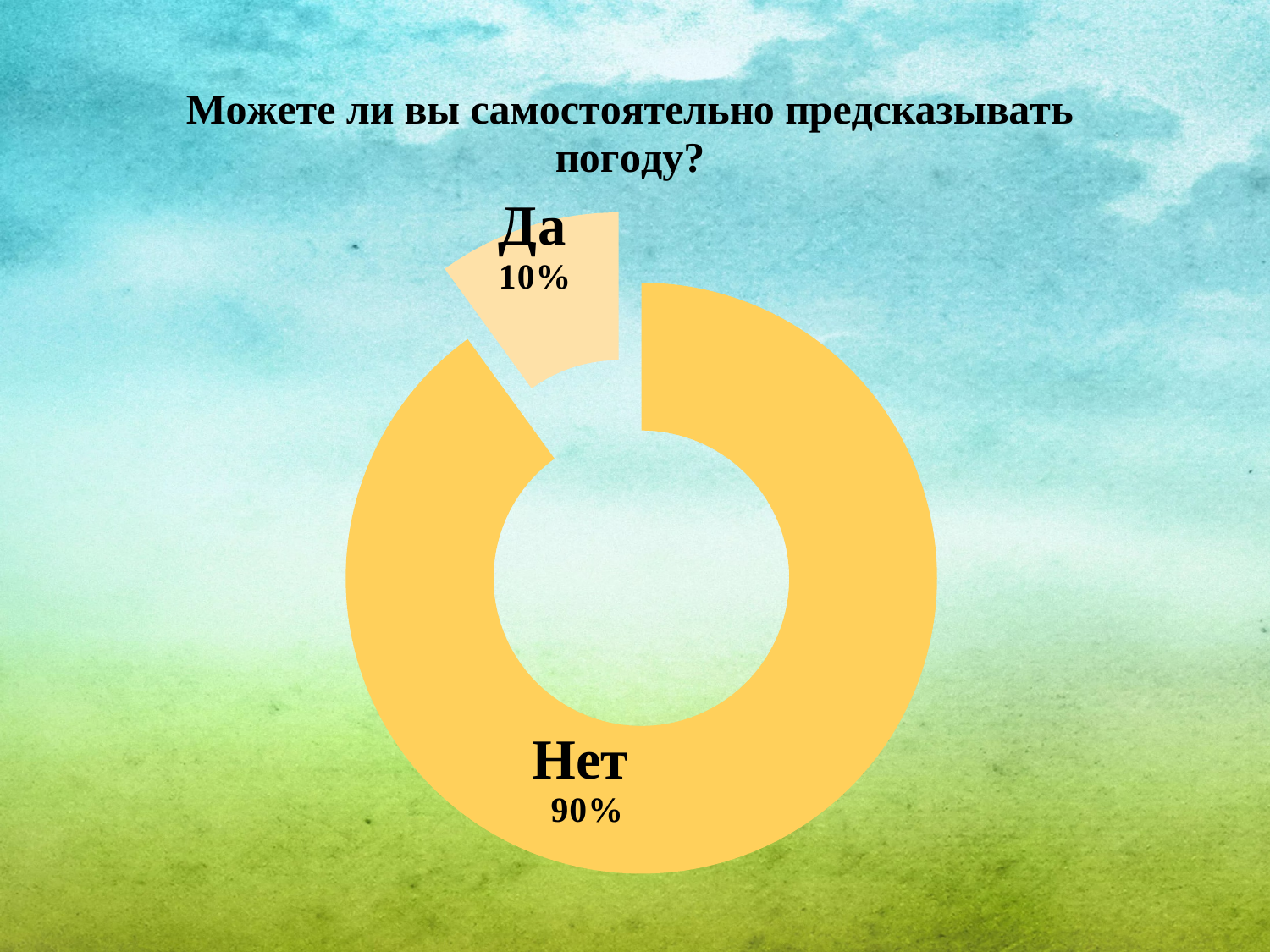
What percentage of respondents answered "Да"? 10% What share of the chart does the "Нет" slice represent? 90% What kind of chart is shown on the slide? Doughnut chart What is the title of the chart? Можете ли вы самостоятельно предсказывать погоду? Which is larger, the share for "Да" or the share for "Нет"? Нет Which answer has the largest share of the chart? Нет What is the difference in percentage points between the "Нет" and "Да" shares? 80 Which slice is separated (exploded) from the rest of the chart? Да How many categories are shown in the chart? 2 What percentage of respondents answered "Нет"? 90% Which answer has the smallest share of the chart? Да